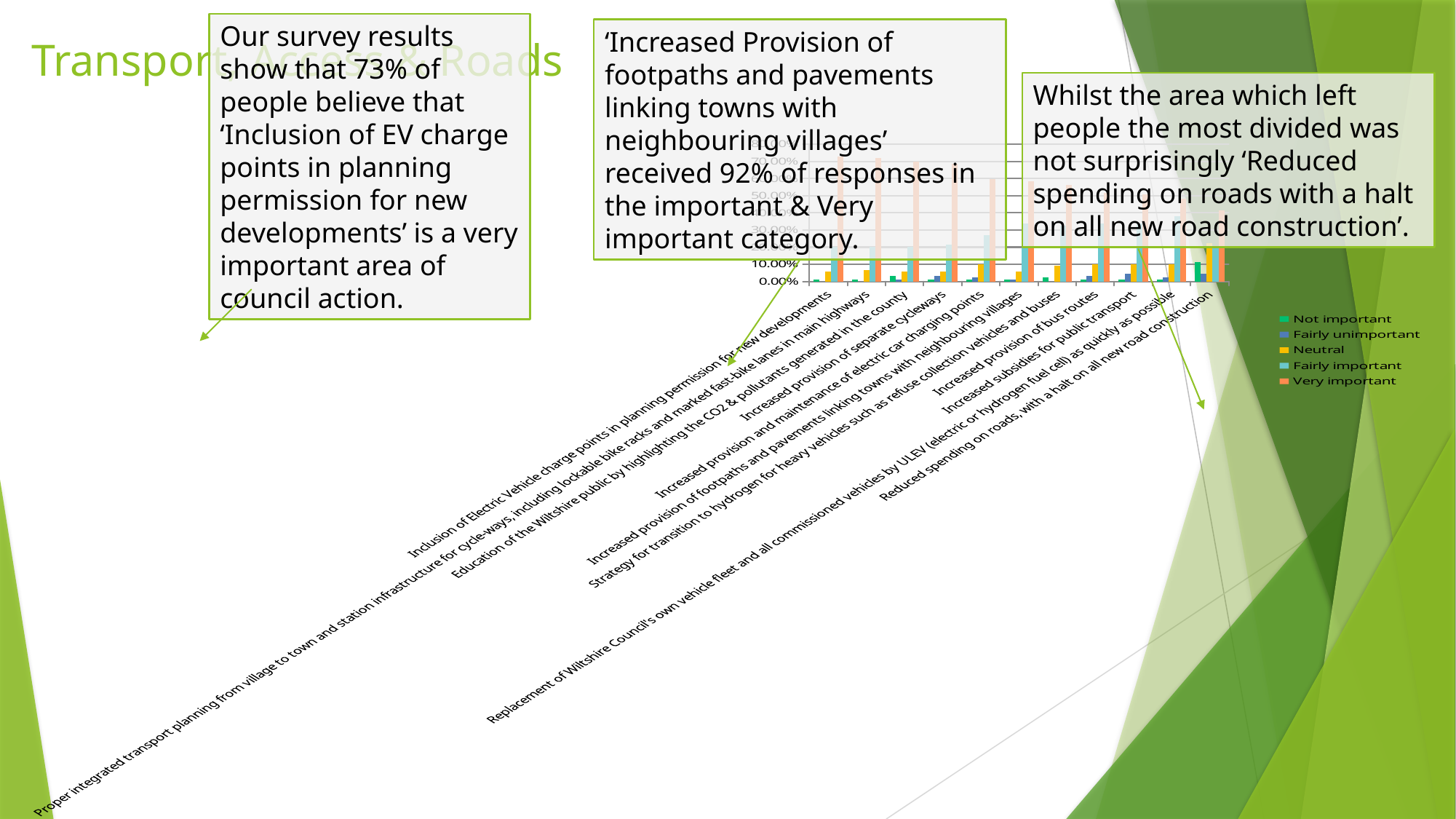
Which category has the highest 'Not important' value? Reduced spending on roads, with a halt on all new road construction Is the 'Very important' value for 'Inclusion of Electric Vehicle charge points in planning permission for new developments' greater or less than 50.00%? greater Which legend entry is shown in green? Not important Is the 'Fairly unimportant' value for 'Increased provision of separate cycleways' greater or less than 10.00%? less Which legend entry is shown in orange? Very important For 'Inclusion of Electric Vehicle charge points in planning permission for new developments', which is larger: the 'Very important' value or the 'Not important' value? Very important Is the 'Not important' value for 'Inclusion of Electric Vehicle charge points in planning permission for new developments' greater or less than 10.00%? less How many categories are plotted along the x axis of the chart? 11 What kind of chart is shown on the slide? bar chart How many series does the chart legend list? 5